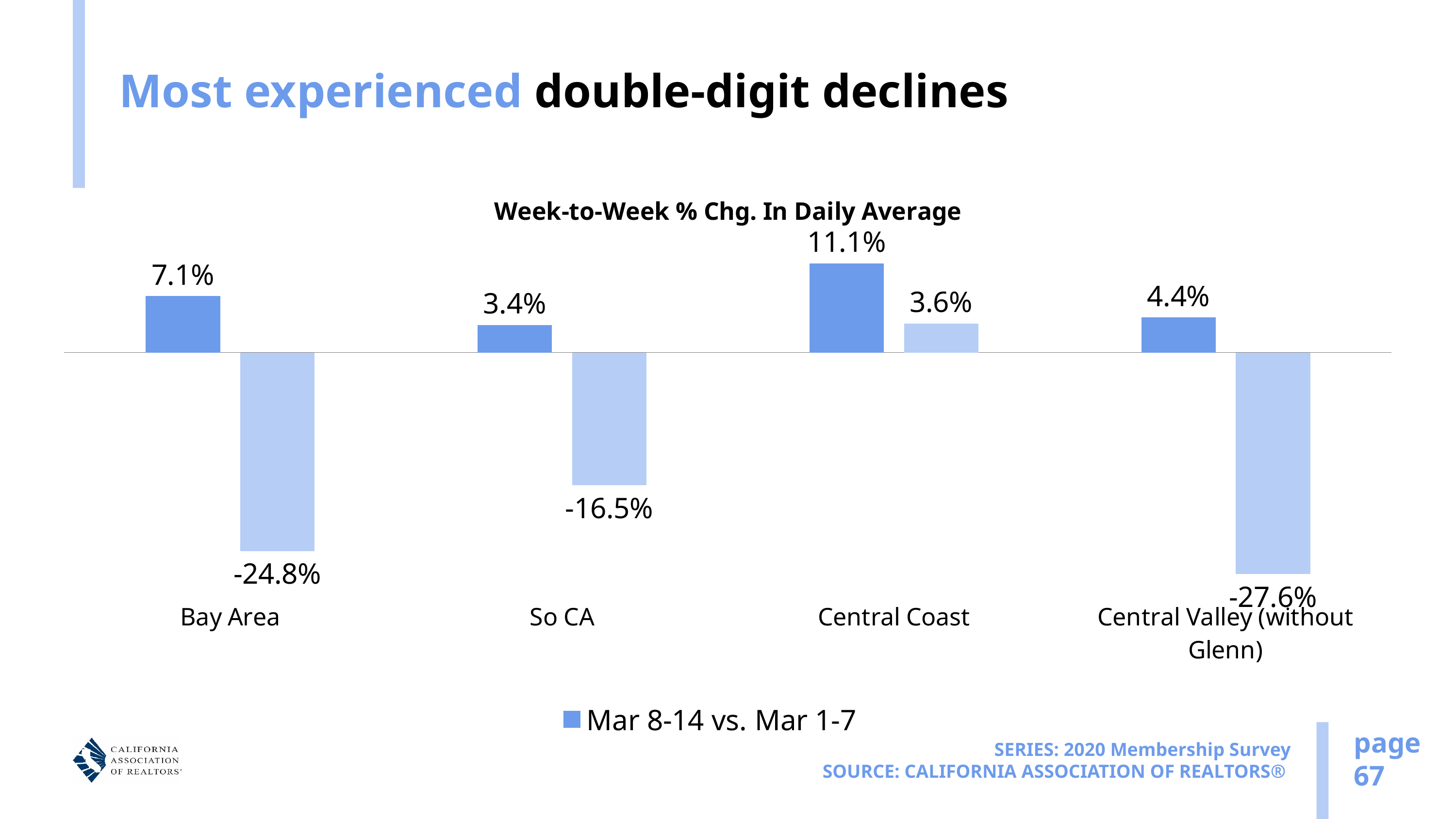
What value is labelled on the lighter second bar for So CA? -16.5% Which category has the highest Mar 8-14 vs. Mar 1-7 value? Central Coast How many series does the legend list? 1 What is the difference between the two bars for Central Coast (11.1% and 3.6%)? 7.5 percentage points How many categories are shown on the x axis? 4 What is the Mar 8-14 vs. Mar 1-7 value for Bay Area? 7.1% What is the Mar 8-14 vs. Mar 1-7 value for Central Coast? 11.1% What kind of chart is shown on the slide? Bar chart Which category has the lowest value among the lighter second bars? Central Valley (without Glenn) What value is labelled on the lighter second bar for Central Coast? 3.6% Which is larger, the Mar 8-14 vs. Mar 1-7 value for Bay Area or for Central Valley (without Glenn)? Bay Area What is the difference between the two bars for Bay Area (7.1% and -24.8%)? 31.9 percentage points